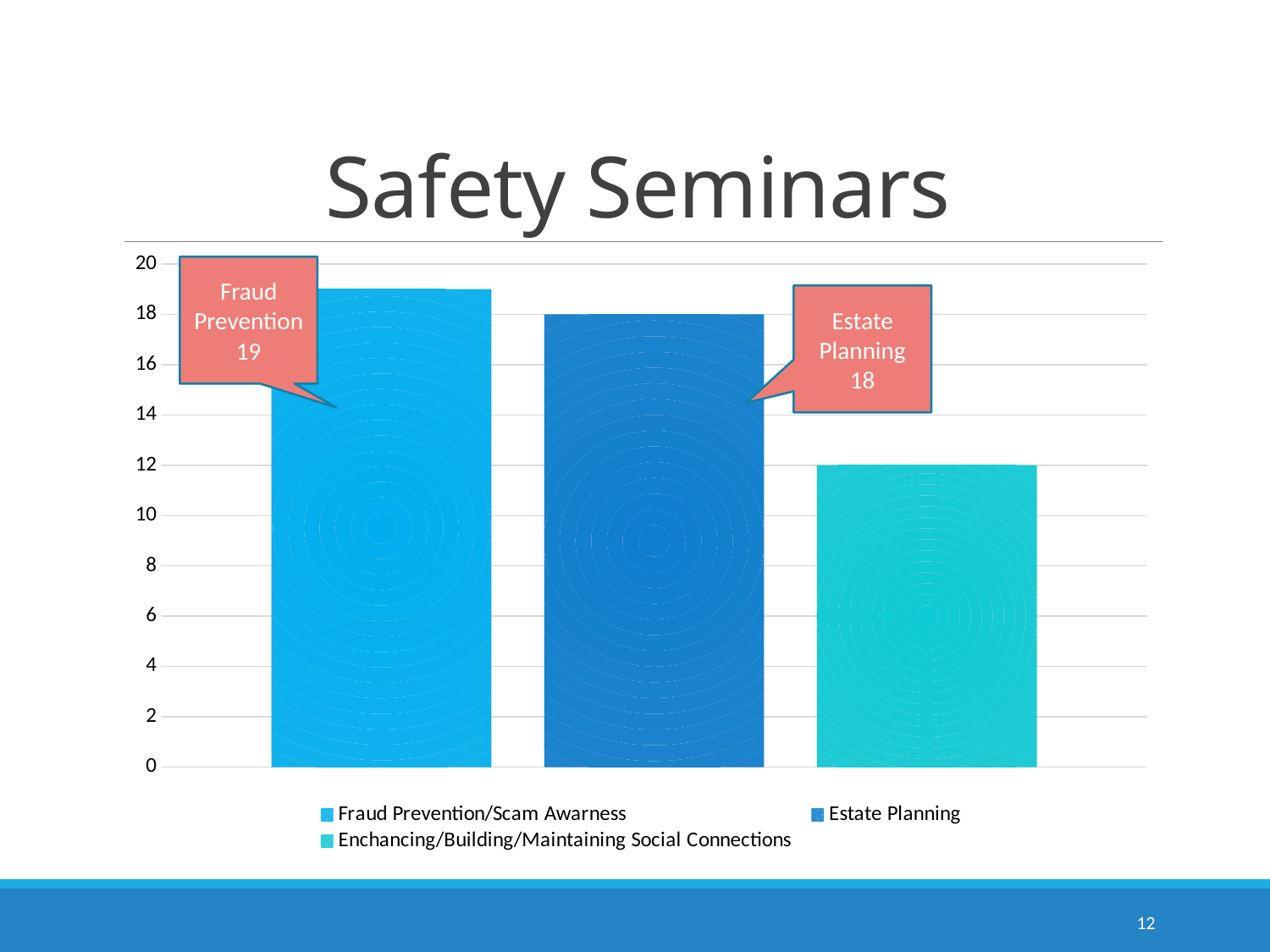
Is the value for Enchancing/Building/Maintaining Social Connections greater or less than 16? less What kind of chart is shown on the slide? bar chart What is the title of the slide containing the chart? Safety Seminars What is the value for Fraud Prevention? 19 What is the difference between the values for Fraud Prevention and Estate Planning? 1 Which category has the lowest value? Enchancing/Building/Maintaining Social Connections How many bars are plotted in the chart? 3 What is the value for Enchancing/Building/Maintaining Social Connections? 12 Which category has the highest value? Fraud Prevention/Scam Awarness What is the value for Estate Planning? 18 Which is larger, the value for Estate Planning or the value for Enchancing/Building/Maintaining Social Connections? Estate Planning What is the difference between the values for Estate Planning and Enchancing/Building/Maintaining Social Connections? 6